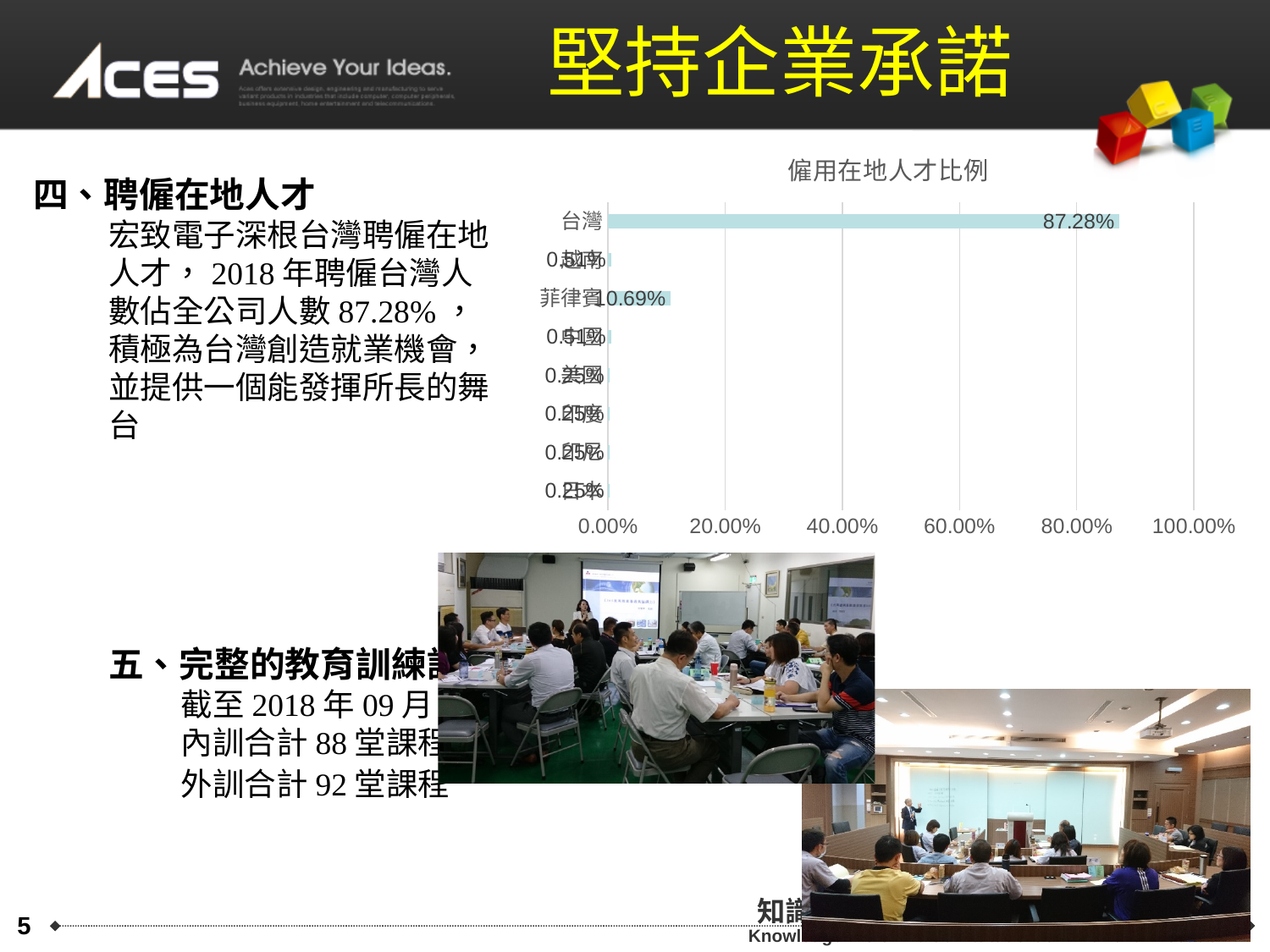
What kind of chart is shown on the slide? bar chart What is the difference between the values for 台灣 and 菲律賓? 76.59% Is the value for 台灣 greater or less than 80.00%? greater What is the title of the chart? 僱用在地人才比例 What is the maximum value shown on the horizontal axis of the chart? 100.00% What is the value for 菲律賓 in the chart? 10.69% Which is larger, the value for 台灣 or the value for 菲律賓? 台灣 Which category has the highest value in the chart? 台灣 What is the value for 台灣 in the chart? 87.28% How many categories are shown in the chart? 8 Is the value for 菲律賓 greater or less than 20.00%? less